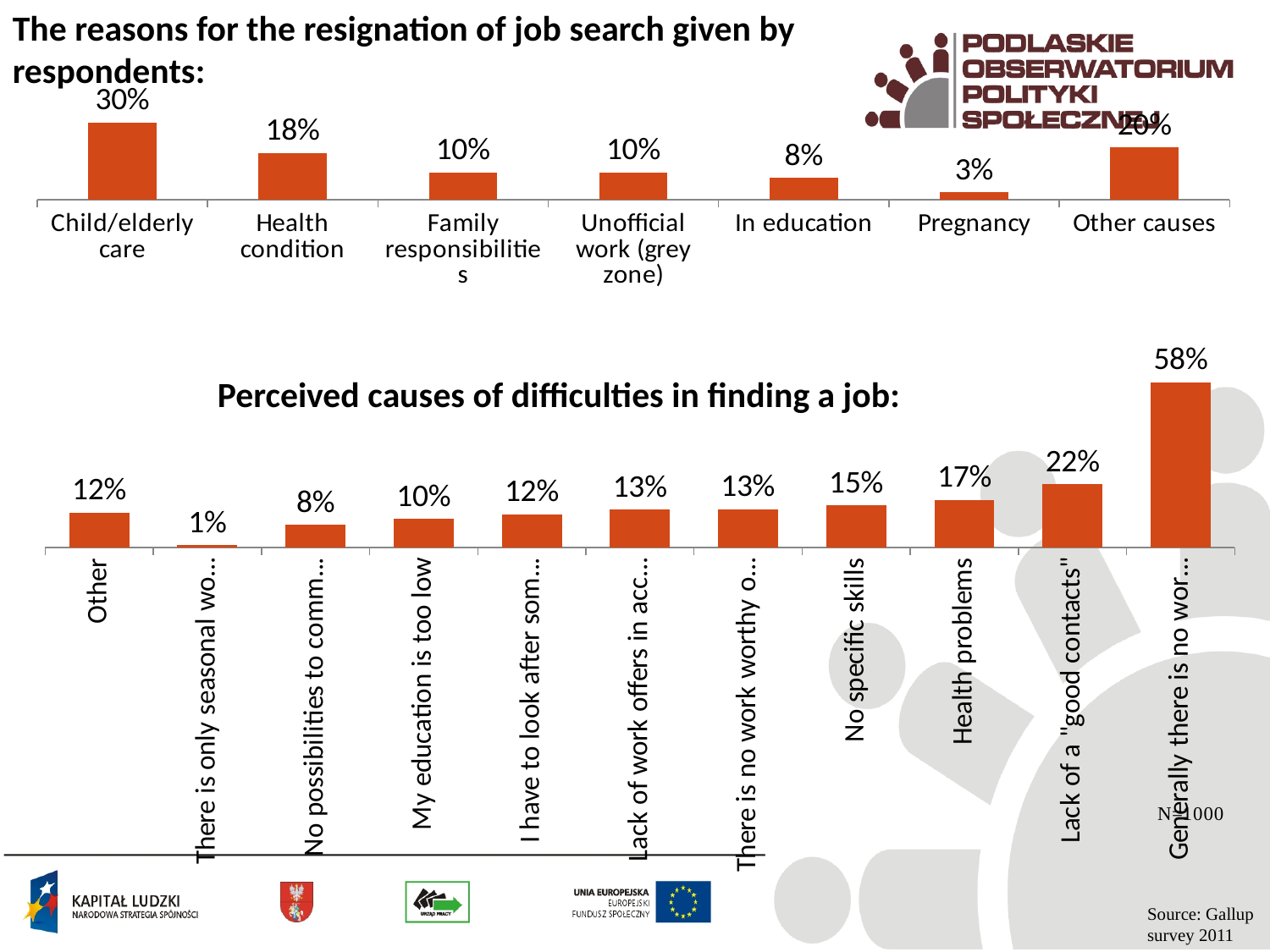
What type of chart is the bottom chart 'Perceived causes of difficulties in finding a job'? Bar chart In the bottom chart 'Perceived causes of difficulties in finding a job', which is larger: Lack of a "good contacts" or My education is too low? Lack of a "good contacts" In the top chart on reasons for resignation of job search, what percentage is shown for Child/elderly care? 30% In the top chart on reasons for resignation of job search, which category has the lowest value? Pregnancy In the bottom chart 'Perceived causes of difficulties in finding a job', what is the lowest value shown? 1% In the bottom chart 'Perceived causes of difficulties in finding a job', what percentage is shown for Health problems? 17% In the top chart on reasons for resignation of job search, what is the difference between Health condition and In education? 10% In the top chart on reasons for resignation of job search, which category has the highest value? Child/elderly care In the top chart on reasons for resignation of job search, what percentage is shown for Pregnancy? 3% In the bottom chart 'Perceived causes of difficulties in finding a job', what is the highest value shown? 58% In the bottom chart 'Perceived causes of difficulties in finding a job', what percentage is shown for No specific skills? 15% In the top chart on reasons for resignation of job search, how many categories are shown? 7